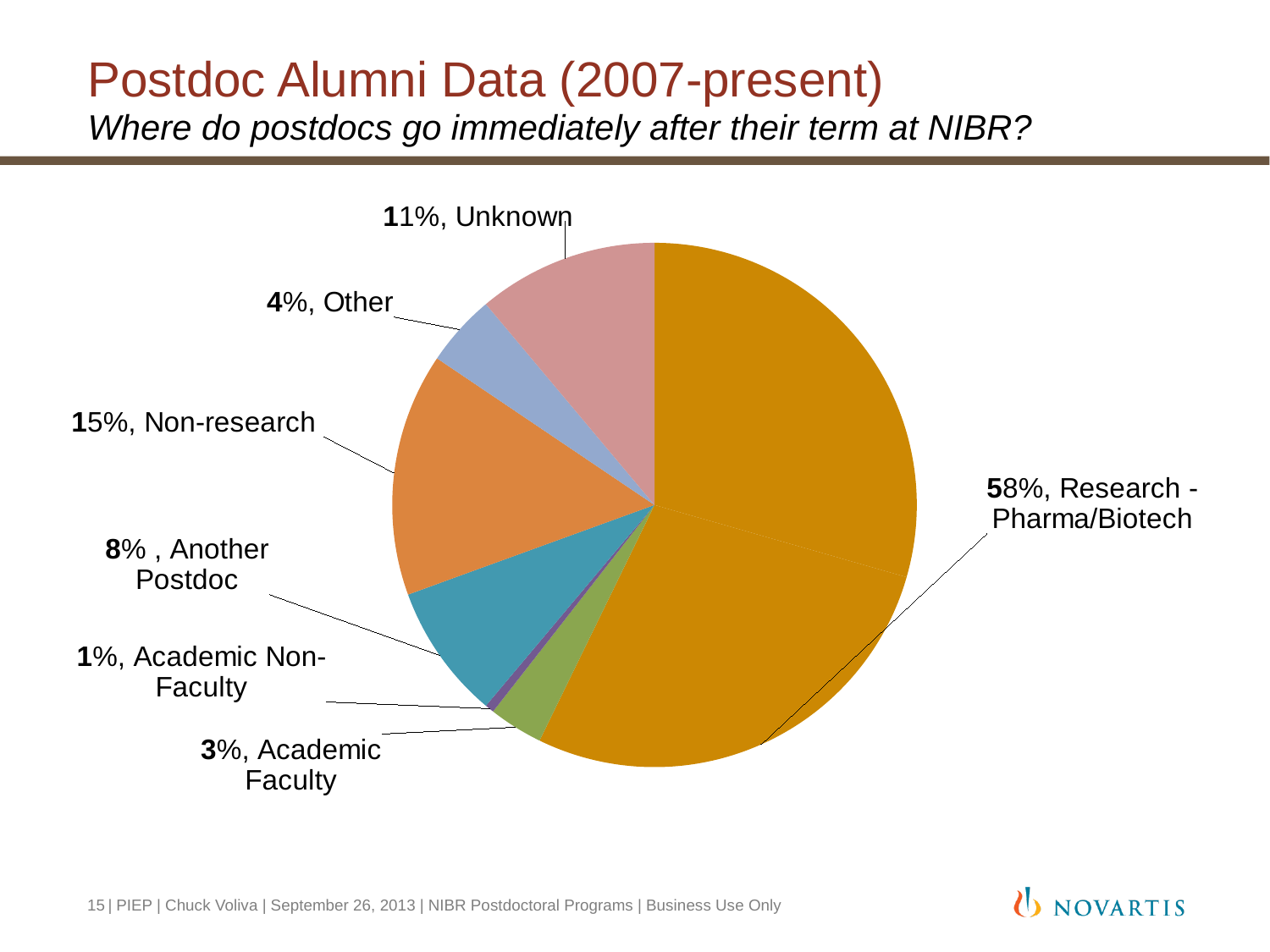
How many categories are shown in the pie chart? 7 What share of postdocs is listed as Unknown? 11% What kind of chart is shown on the slide? pie chart Which category has the largest share of the pie? Research - Pharma/Biotech What share of postdocs go to Academic Faculty? 3% Which category has the smallest share of the pie? Academic Non-Faculty What is the difference between the Non-research share and the Unknown share? 4% Which is larger, the share for Other or the share for Another Postdoc? Another Postdoc What share of postdocs go to Non-research? 15% What is the combined share of Academic Faculty and Academic Non-Faculty? 4% What share of postdocs go to Research - Pharma/Biotech? 58% What share of postdocs go to Another Postdoc? 8%